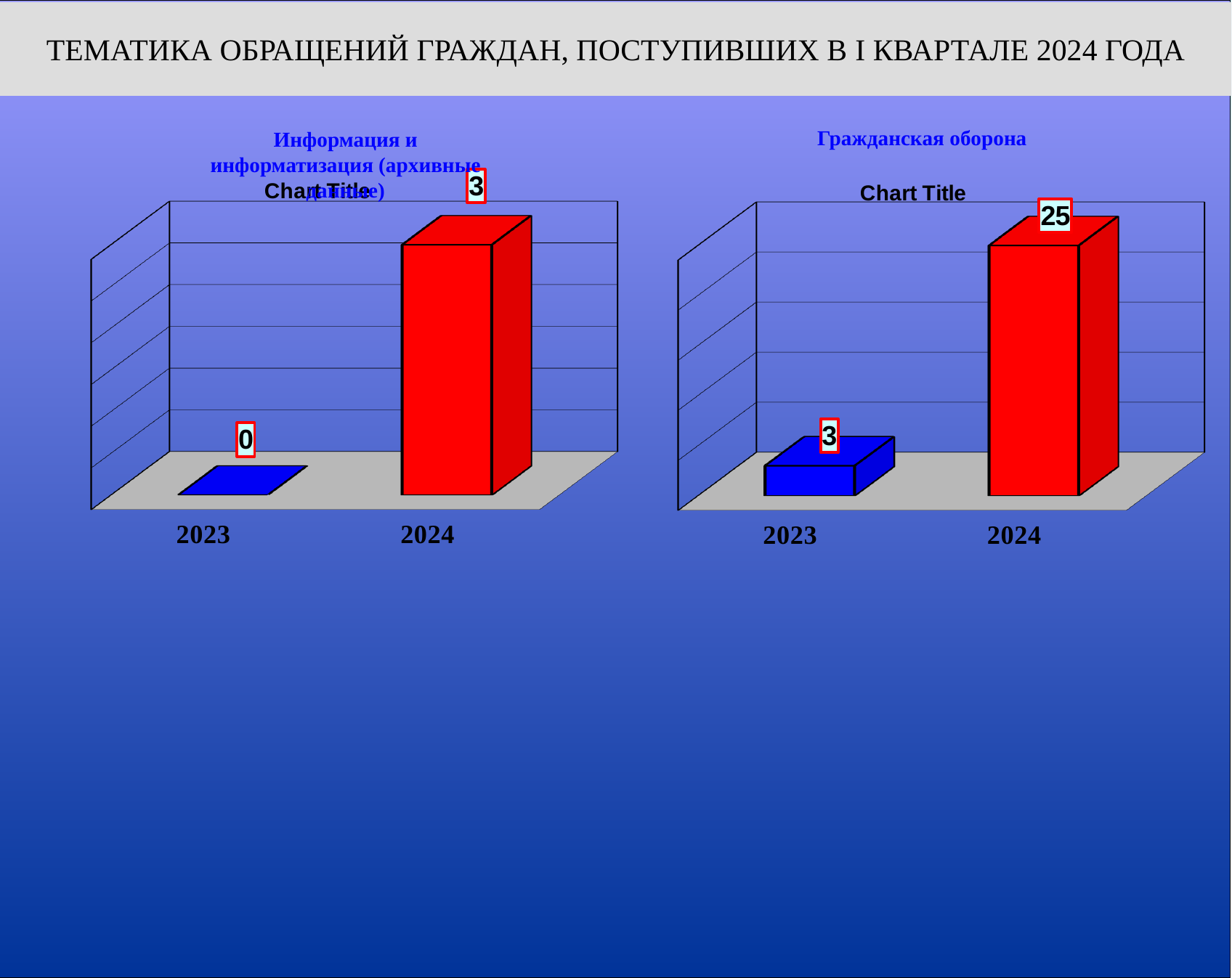
In the right chart (Гражданская оборона), which is larger, the value for 2023 or for 2024? 2024 In the right chart (Гражданская оборона), which year has the highest value? 2024 In the left chart, what is the value for 2023? 0 In the right chart (Гражданская оборона), what is the difference between the 2024 and 2023 values? 22 In the left chart, what is the value for 2024? 3 In the right chart (Гражданская оборона), what is the value for 2024? 25 In the left chart, which year has the lowest value? 2023 In the right chart (Гражданская оборона), do the values rise or fall from 2023 to 2024? rise In the right chart (Гражданская оборона), what is the value for 2023? 3 How many categories are shown on the x axis of the right chart (Гражданская оборона)? 2 In the left chart, what is the difference between the 2024 and 2023 values? 3 What kind of chart is the left chart? bar chart